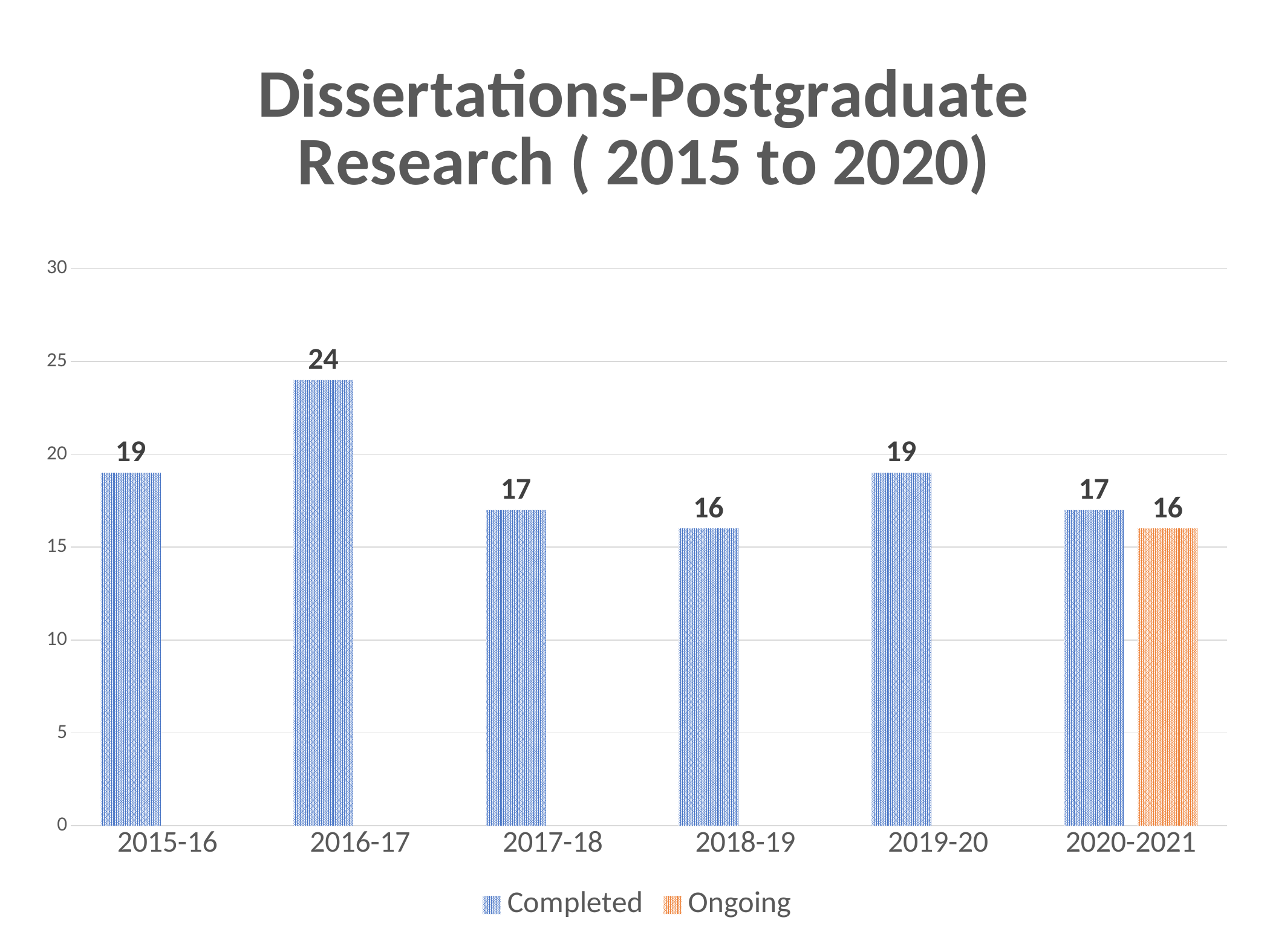
How many year categories are shown on the x axis? 6 What is the difference between the Completed values for 2016-17 and 2017-18? 7 What is the title of the chart? Dissertations-Postgraduate Research ( 2015 to 2020) How many series does the legend list? 2 What is the Completed value for 2016-17? 24 Is the Completed value for 2016-17 greater or less than 20? greater What kind of chart is shown on the slide? bar chart Which is larger, the Completed value for 2015-16 or the Completed value for 2018-19? 2015-16 What is the Ongoing value for 2020-2021? 16 Which year has the lowest Completed value? 2018-19 What is the Completed value for 2018-19? 16 Which year has the highest Completed value? 2016-17